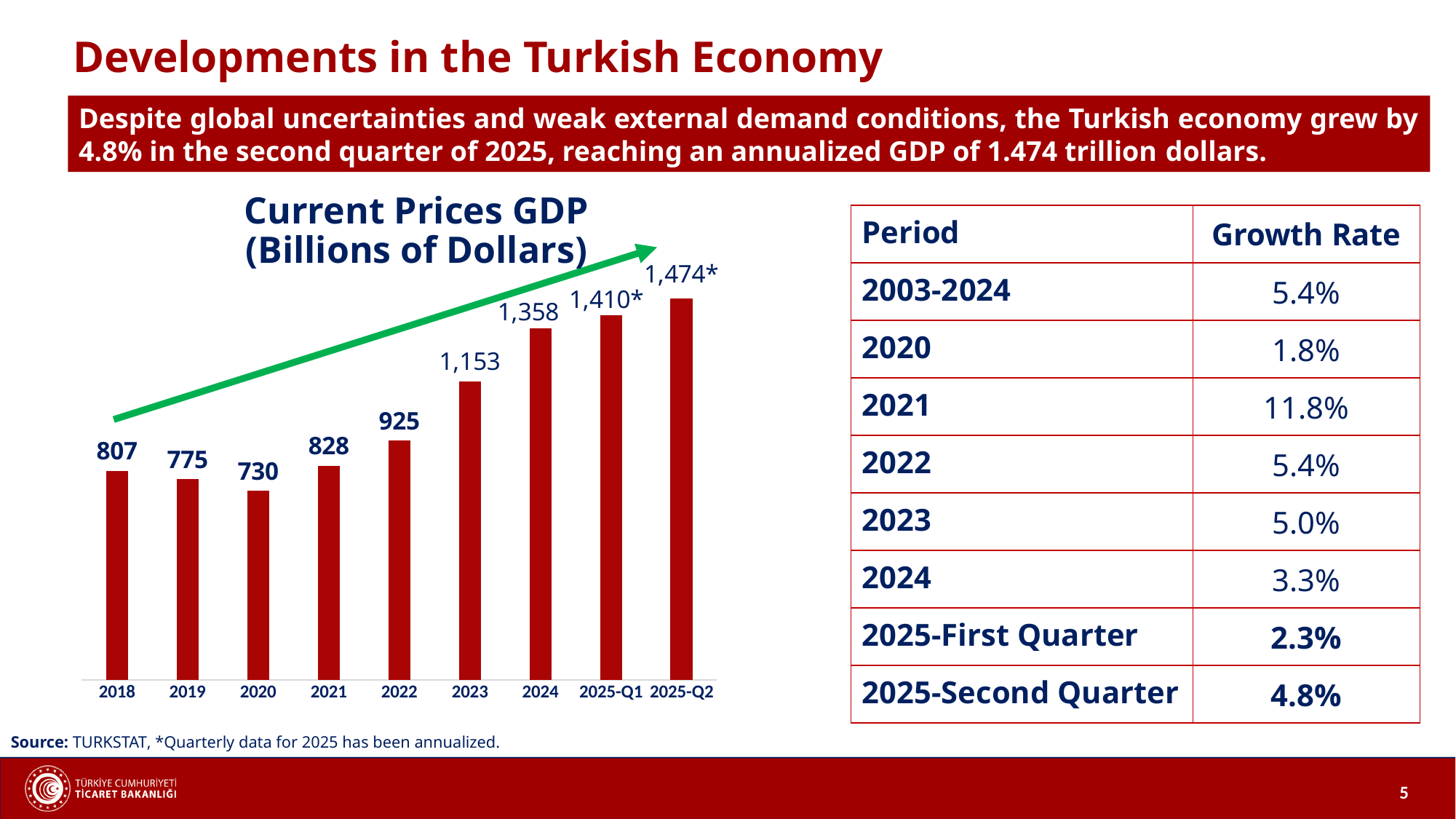
What is the Current Prices GDP value for 2022? 925 What unit is given in the title of the Current Prices GDP chart? Billions of Dollars What is the Current Prices GDP value for 2024? 1,358 What kind of chart is the Current Prices GDP chart? bar chart Which category has the highest Current Prices GDP value? 2025-Q2 What is the Current Prices GDP value labelled for 2025-Q2? 1,474* What is the difference between the Current Prices GDP values for 2023 and 2022? 228 Do the Current Prices GDP values generally rise or fall from 2020 to 2025-Q2? rise Which category has the lowest Current Prices GDP value? 2020 How many categories are shown on the x axis of the Current Prices GDP chart? 9 Which is larger, the Current Prices GDP value for 2019 or for 2021? 2021 What is the Current Prices GDP value for 2018? 807